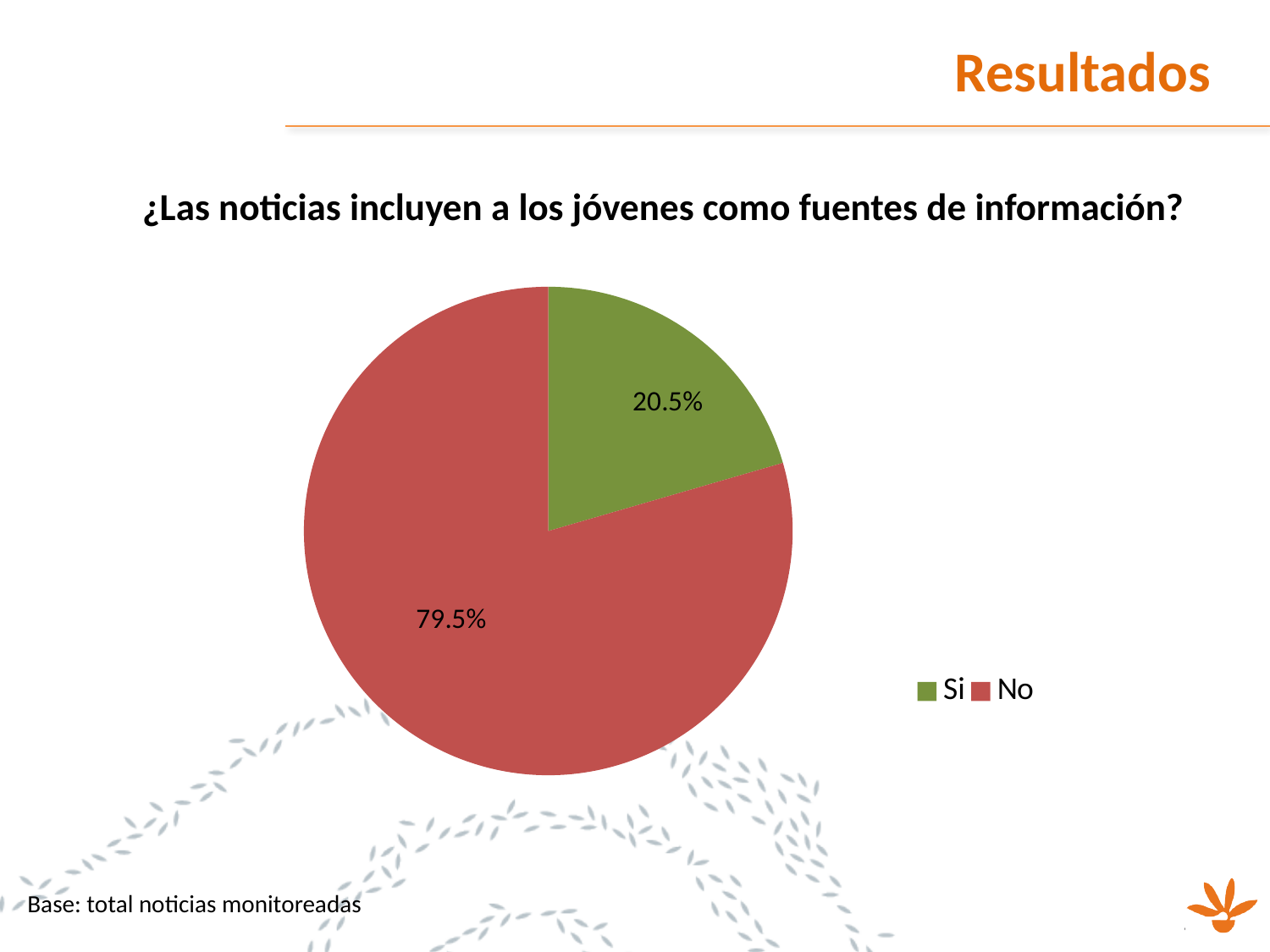
How many slices does the pie chart have? 2 What is the title of the chart? ¿Las noticias incluyen a los jóvenes como fuentes de información? What colour is the "Si" slice? green What kind of chart is shown on the slide? pie chart What is the combined total of the two slices? 100% Which slice is larger, "Si" or "No"? No What is the difference in percentage points between the "No" and "Si" slices? 59 percentage points What percentage of the pie is labelled "Si"? 20.5% How many entries does the legend list? 2 What percentage of the pie is labelled "No"? 79.5% Which category has the largest share of the pie? No Which category has the smallest share of the pie? Si